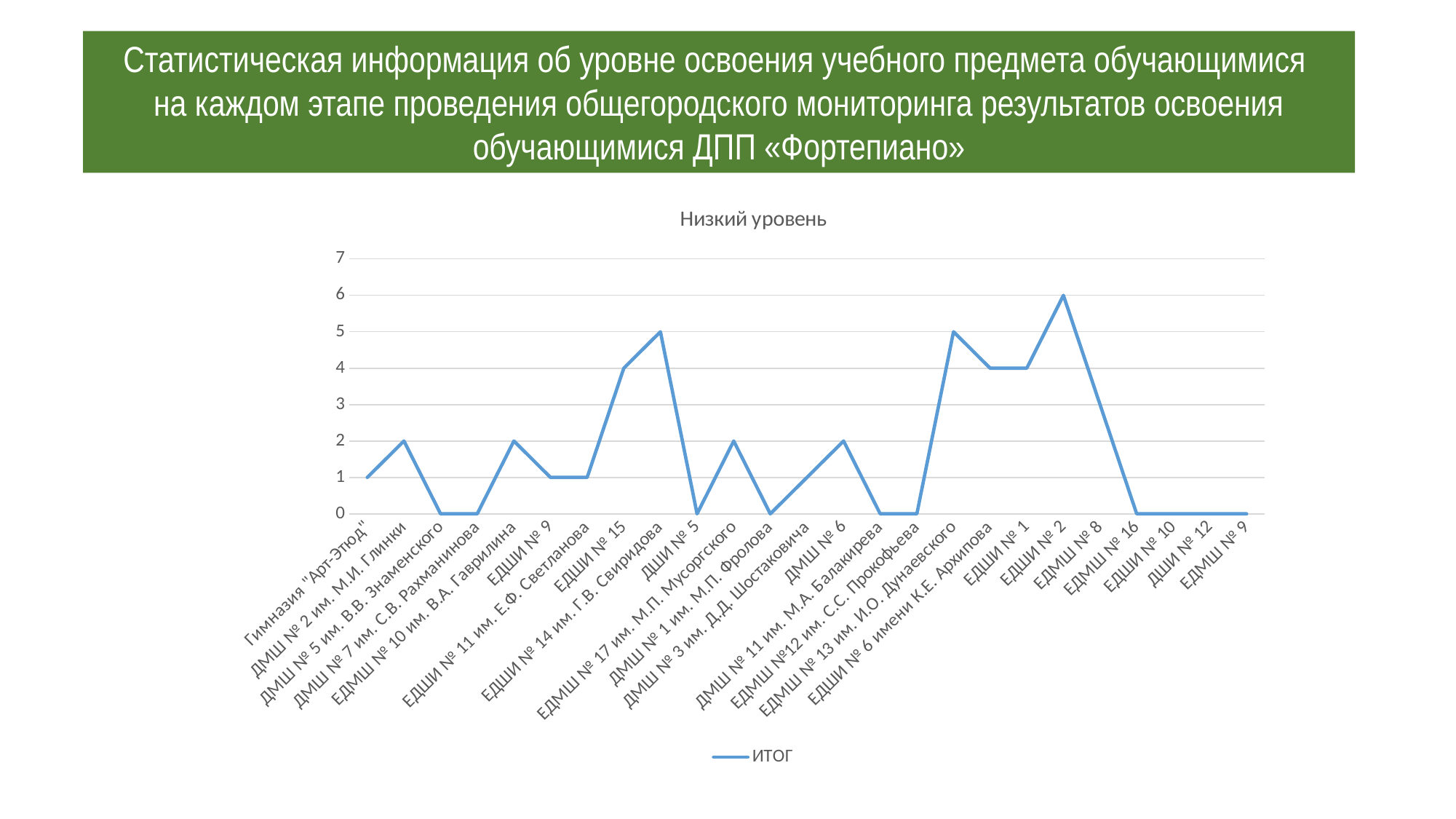
What is the name of the series shown in the legend? ИТОГ Which is larger, the value for ЕДМШ № 13 им. И.О. Дунаевского or the value for ЕДШИ № 6 имени К.Е. Архипова? ЕДМШ № 13 им. И.О. Дунаевского What kind of chart is shown on the slide? line chart What is the value for ЕДШИ № 14 им. Г.В. Свиридова? 5 What is the value for ДМШ № 2 им. М.И. Глинки? 2 How many schools (categories) are plotted along the x axis? 25 What is the title of the chart? Низкий уровень Which school has the highest value on the chart? ЕДШИ № 2 What is the difference between the value for ЕДШИ № 2 and the value for ЕДШИ № 1? 2 What is the value for ЕДШИ № 2? 6 What is the value for ЕДШИ № 15? 4 How many series does the legend list? 1